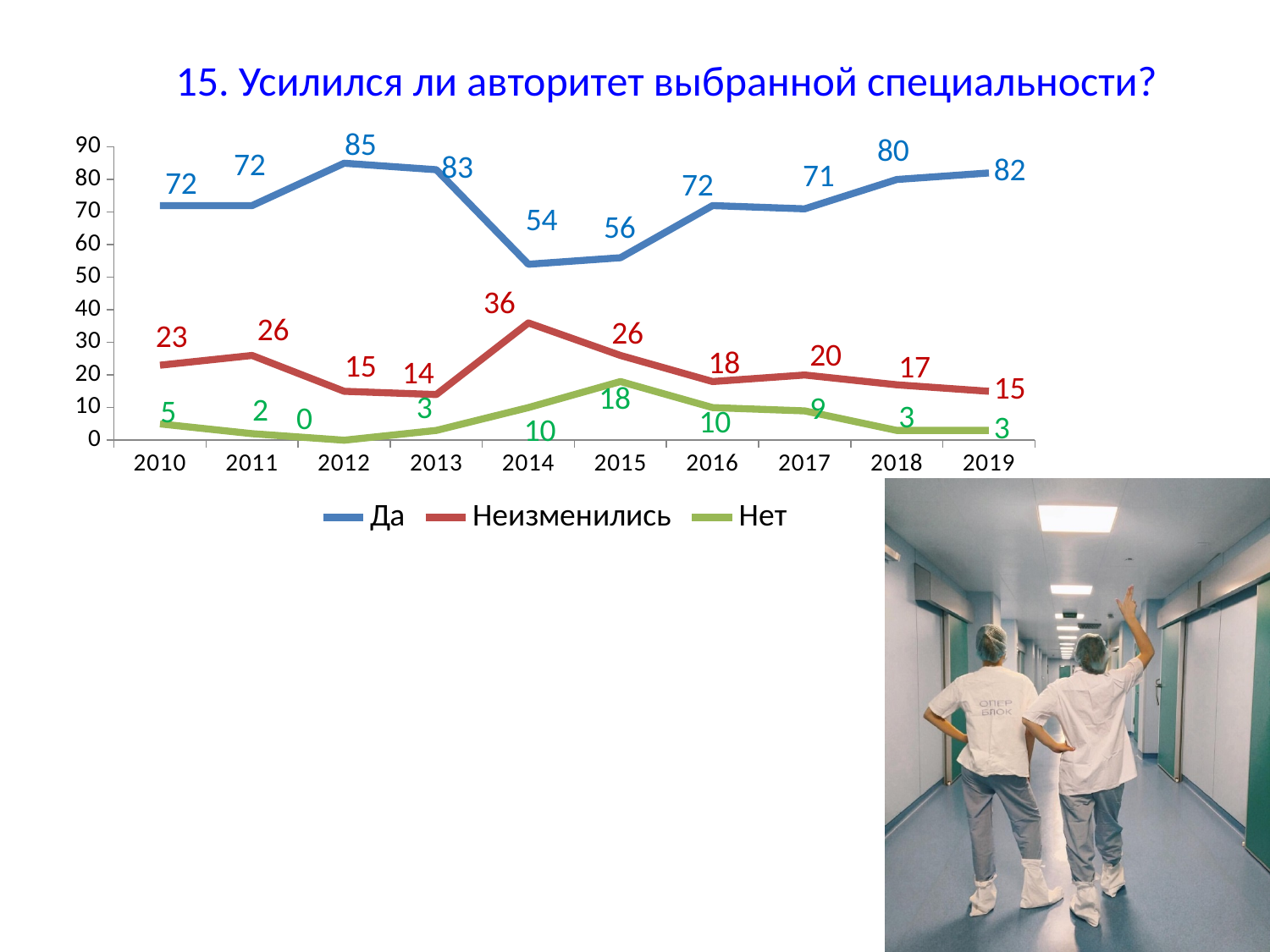
What is the value for "Да" in 2014? 54 How many series does the legend list? 3 In which year is the value for "Нет" lowest? 2012 What type of chart is shown on the slide? line chart How many years are shown on the x axis? 10 What is the difference between the "Да" values in 2012 and 2014? 31 Which is larger: the "Неизменились" value in 2014 or in 2011? 2014 What is the title of the chart? 15. Усилился ли авторитет выбранной специальности? Does the "Да" series rise or fall from 2015 to 2019? rise In which year is the value for "Да" highest? 2012 What is the value for "Неизменились" in 2017? 20 What is the value for "Нет" in 2015? 18